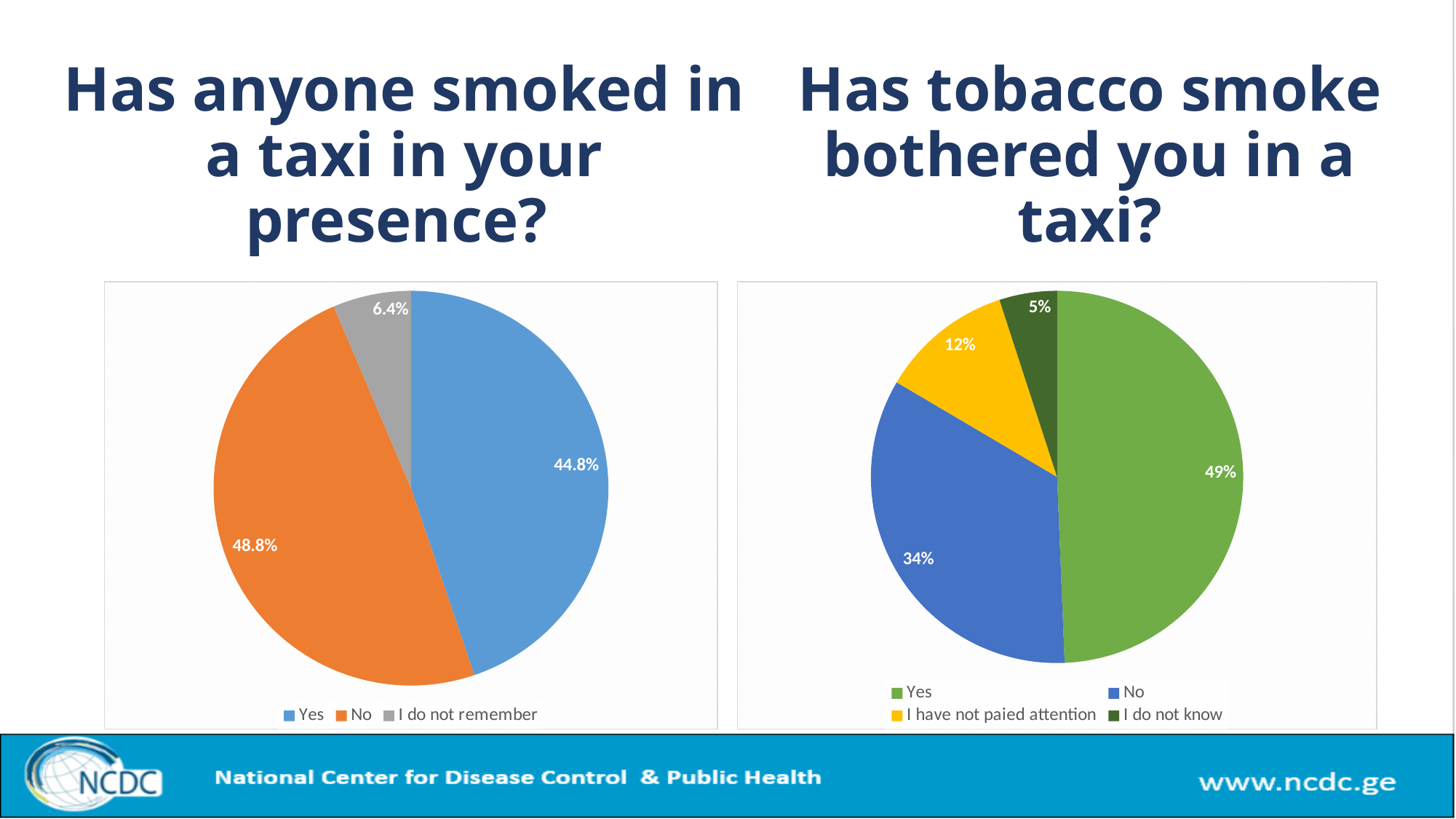
In the chart titled "Has anyone smoked in a taxi in your presence?", which response has the largest share? No In the chart titled "Has anyone smoked in a taxi in your presence?", what percentage answered "I do not remember"? 6.4% In the chart titled "Has tobacco smoke bothered you in a taxi?", how many categories does the legend list? 4 In the chart titled "Has anyone smoked in a taxi in your presence?", how many slices does the pie have? 3 In the chart titled "Has tobacco smoke bothered you in a taxi?", which response has the smallest share? I do not know In the chart titled "Has tobacco smoke bothered you in a taxi?", what percentage answered "I have not paied attention"? 12% In the chart titled "Has anyone smoked in a taxi in your presence?", what percentage answered "No"? 48.8% In the chart titled "Has anyone smoked in a taxi in your presence?", what is the difference in percentage points between "No" and "Yes"? 4 percentage points What type of chart is used on the right side of the slide, titled "Has tobacco smoke bothered you in a taxi?"? Pie chart In the chart titled "Has anyone smoked in a taxi in your presence?", which response has the smallest share? I do not remember In the chart titled "Has tobacco smoke bothered you in a taxi?", which is larger, "Yes" or "No"? Yes In the chart titled "Has tobacco smoke bothered you in a taxi?", what percentage answered "Yes"? 49%